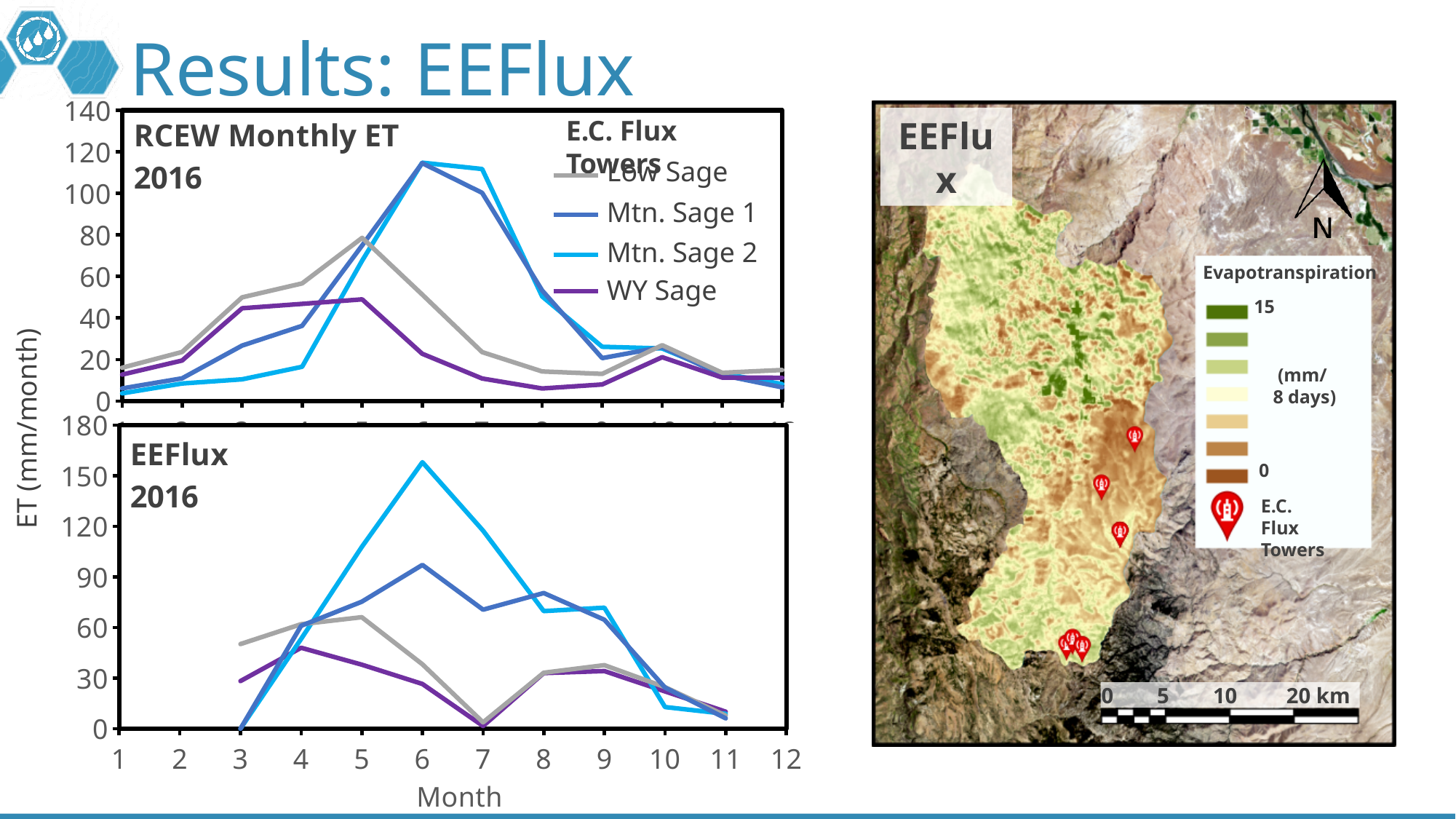
In the RCEW Monthly ET 2016 chart, which series has the lowest value in month 6? WY Sage In the EEFlux 2016 chart, is the value for Mtn. Sage 2 in month 6 greater or less than 150? greater What kind of chart is the RCEW Monthly ET 2016 chart? Line chart What is the label on the shared y axis of the two line charts? ET (mm/month) In the EEFlux 2016 chart, is the value for WY Sage in month 7 greater or less than 30? less How many series does the legend of the RCEW Monthly ET 2016 chart list? 4 In the EEFlux 2016 chart, does the Mtn. Sage 2 line rise or fall from month 6 to month 10? fall In the RCEW Monthly ET 2016 chart, is the value for Mtn. Sage 2 in month 6 greater or less than 100? greater In the EEFlux 2016 chart, which series reaches the highest value? Mtn. Sage 2 In the EEFlux 2016 chart, which is larger in month 6: Mtn. Sage 2 or Low Sage? Mtn. Sage 2